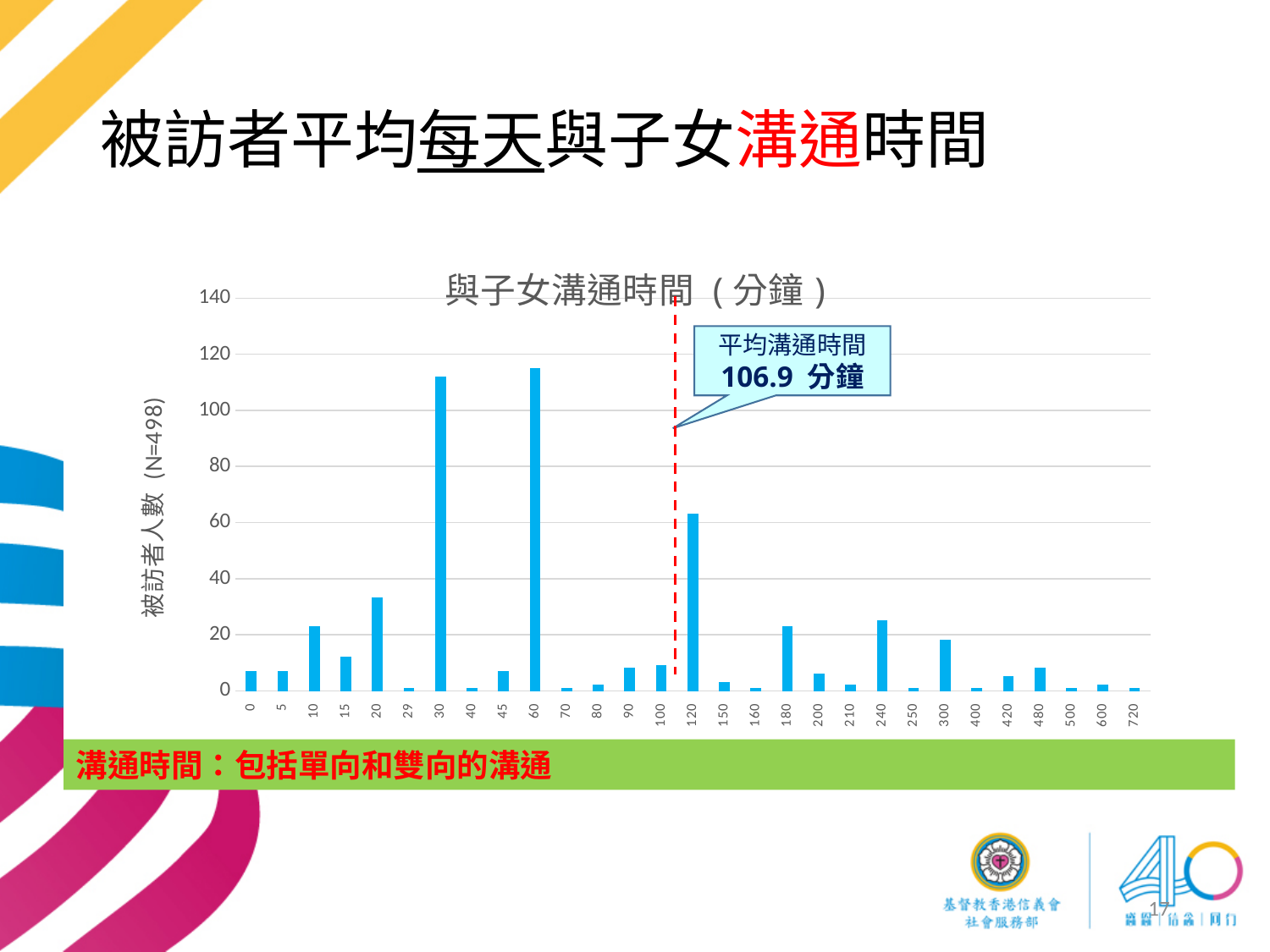
What kind of chart is shown on the slide? bar chart Which has the larger value, the 30 category or the 120 category? 30 What average communication time is shown in the annotation on the chart? 106.9 分鐘 Is the value for the 30 category greater or less than 100? greater How many categories are shown on the x axis of the chart? 29 Which has the larger value, the 240 category or the 480 category? 240 Is the value for the 180 category greater or less than 40? less What is the title of the chart? 與子女溝通時間（分鐘） Is the value for the 120 category greater or less than 40? greater Which has the larger value, the 20 category or the 10 category? 20